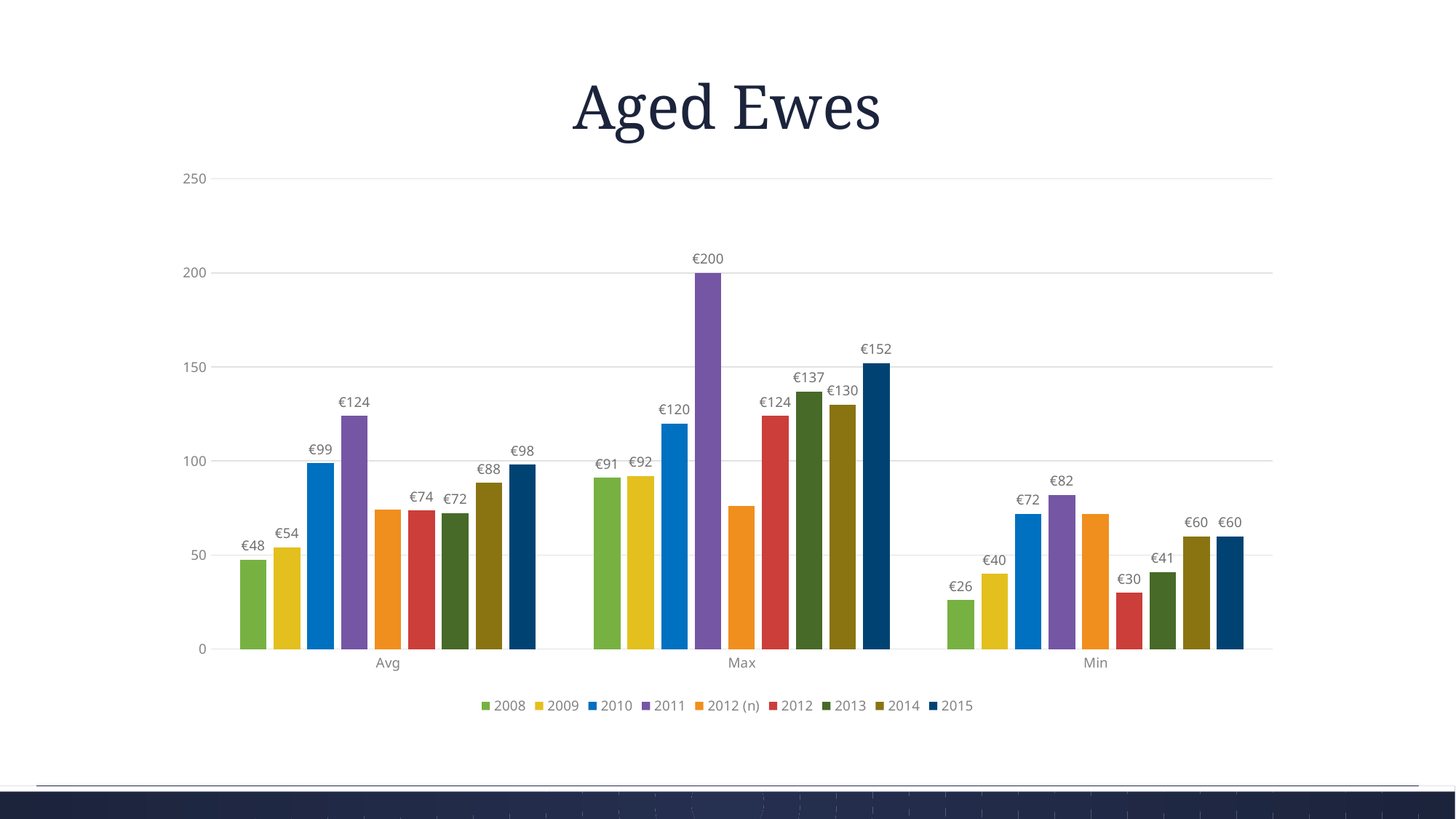
What is the value for 2015 in the Min category? €60 Which year has the highest value in the Max category? 2011 Is the value for 2012 (n) in the Max category greater or less than 100? less What is the value for 2011 in the Max category? €200 What is the title of the chart? Aged Ewes What kind of chart is shown on the slide? bar chart How many categories are shown on the x axis? 3 What is the value for 2008 in the Avg category? €48 Which year has the lowest value in the Min category? 2008 How many series does the legend list? 9 Which is larger in the Avg category: the value for 2010 or the value for 2015? 2010 What is the difference between the 2015 and 2008 values in the Max category? €61